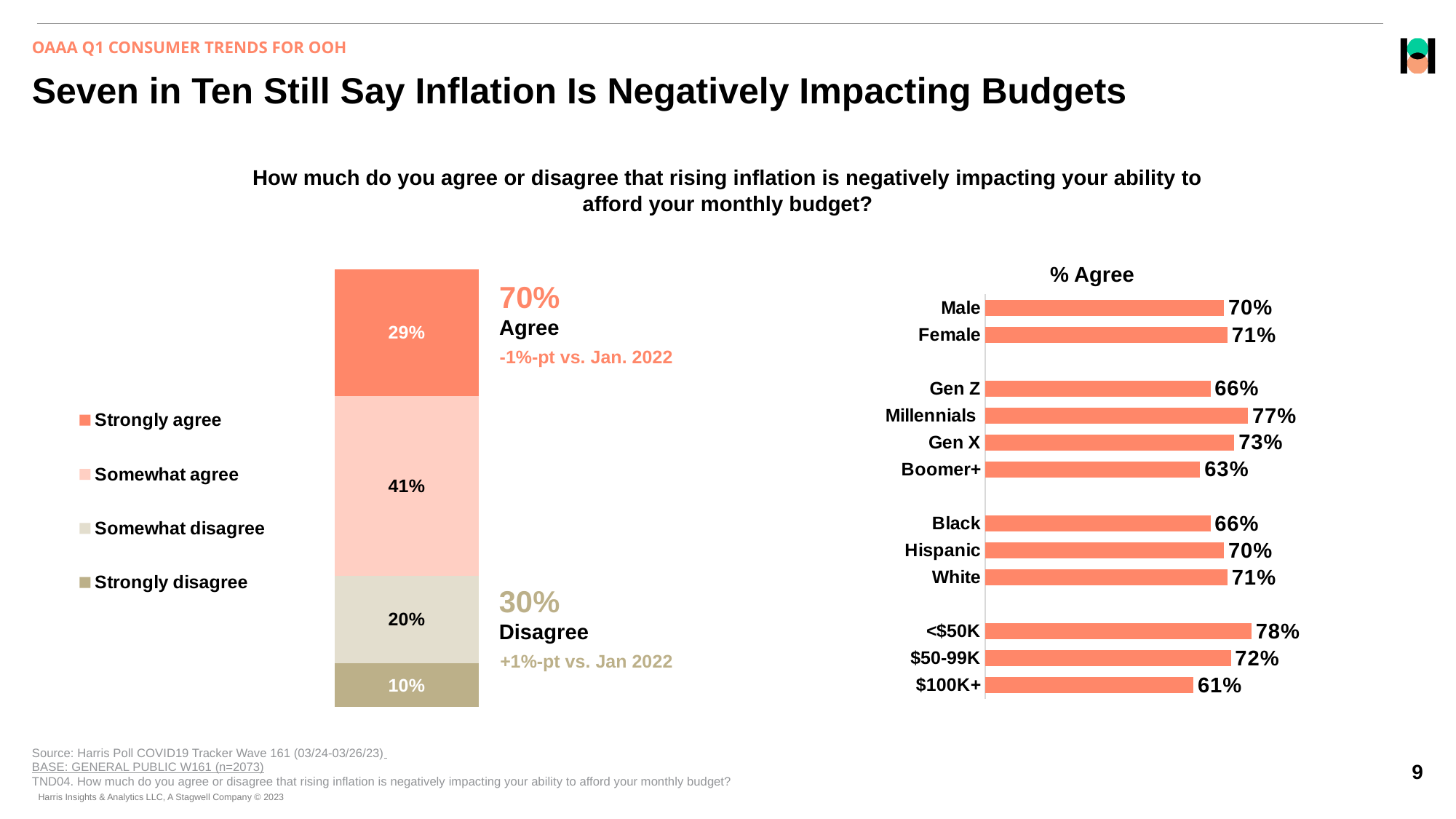
In the stacked bar chart on the left, what is the combined share of strongly agree and somewhat agree? 70% In the stacked bar chart on the left, what percentage of respondents somewhat agree? 41% In the '% Agree' chart on the right, which category has the highest value? <$50K In the '% Agree' chart on the right, how many categories are shown? 12 In the '% Agree' chart on the right, which category has the lowest value? $100K+ In the '% Agree' chart on the right, what is the value for Millennials? 77% In the '% Agree' chart on the right, what is the difference between Gen X and Gen Z? 7% In the stacked bar chart on the left, what percentage of respondents strongly disagree? 10% In the stacked bar chart on the left, what percentage of respondents strongly agree? 29% In the '% Agree' chart on the right, which is larger, the value for Female or the value for Black? Female In the stacked bar chart on the left, how many series does the legend list? 4 In the '% Agree' chart on the right, what is the value for Boomer+? 63%